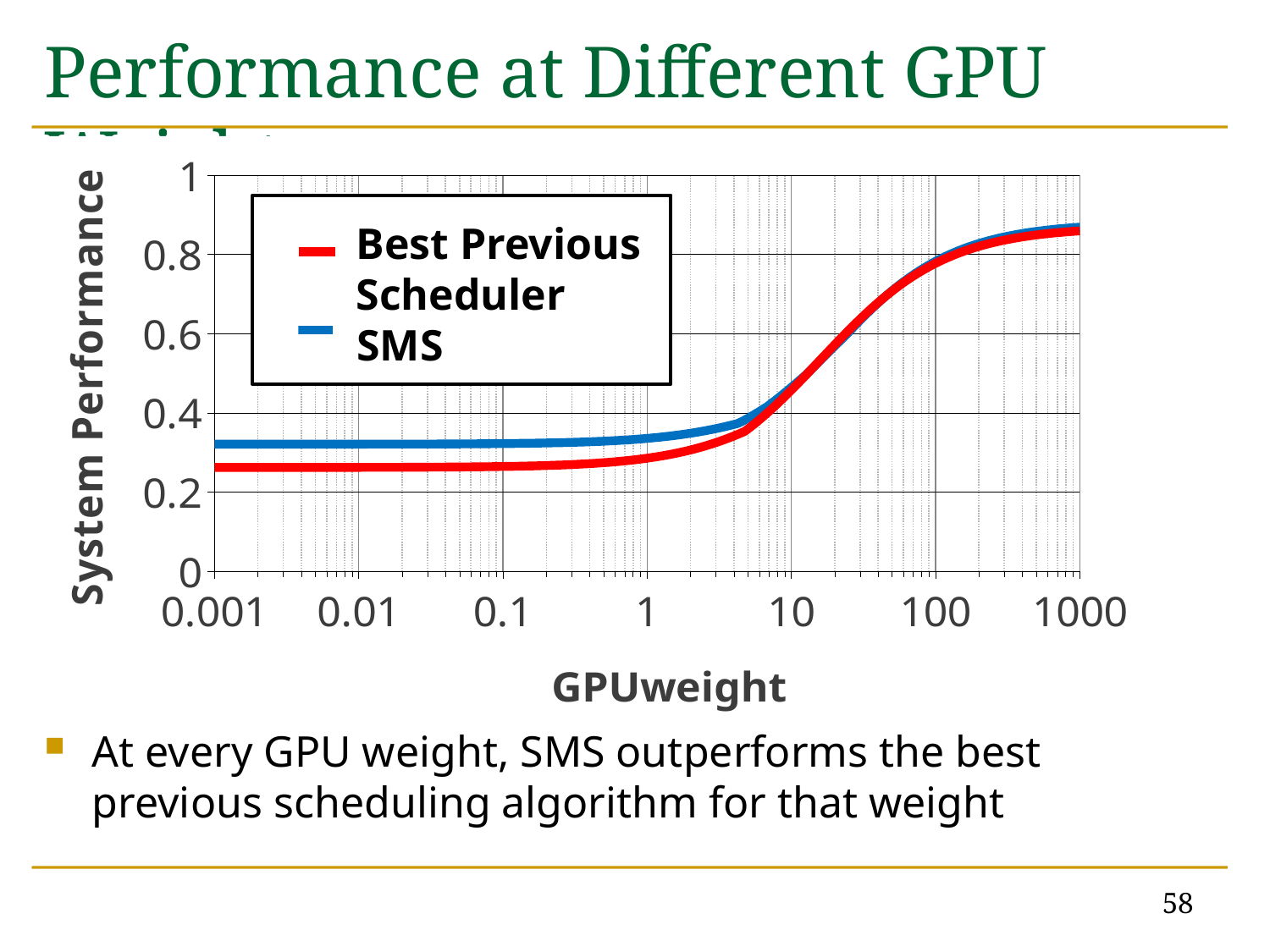
Is the System Performance of the Best Previous Scheduler at a GPUweight of 0.1 greater or less than 0.4? less Is the System Performance of the Best Previous Scheduler at a GPUweight of 0.001 greater or less than 0.2? greater How many series does the legend list? 2 What are the two series named in the legend? Best Previous Scheduler and SMS What kind of chart is shown on the slide? line chart At a GPUweight of 1, which series has the higher System Performance, SMS or Best Previous Scheduler? SMS What is the label of the x axis? GPUweight Is the System Performance of SMS at a GPUweight of 0.001 greater or less than 0.4? less How many labeled tick values are shown on the GPUweight axis? 7 Do the System Performance values rise or fall as GPUweight increases from 0.001 to 1000? rise At a GPUweight of 0.01, which series has the higher System Performance, SMS or Best Previous Scheduler? SMS